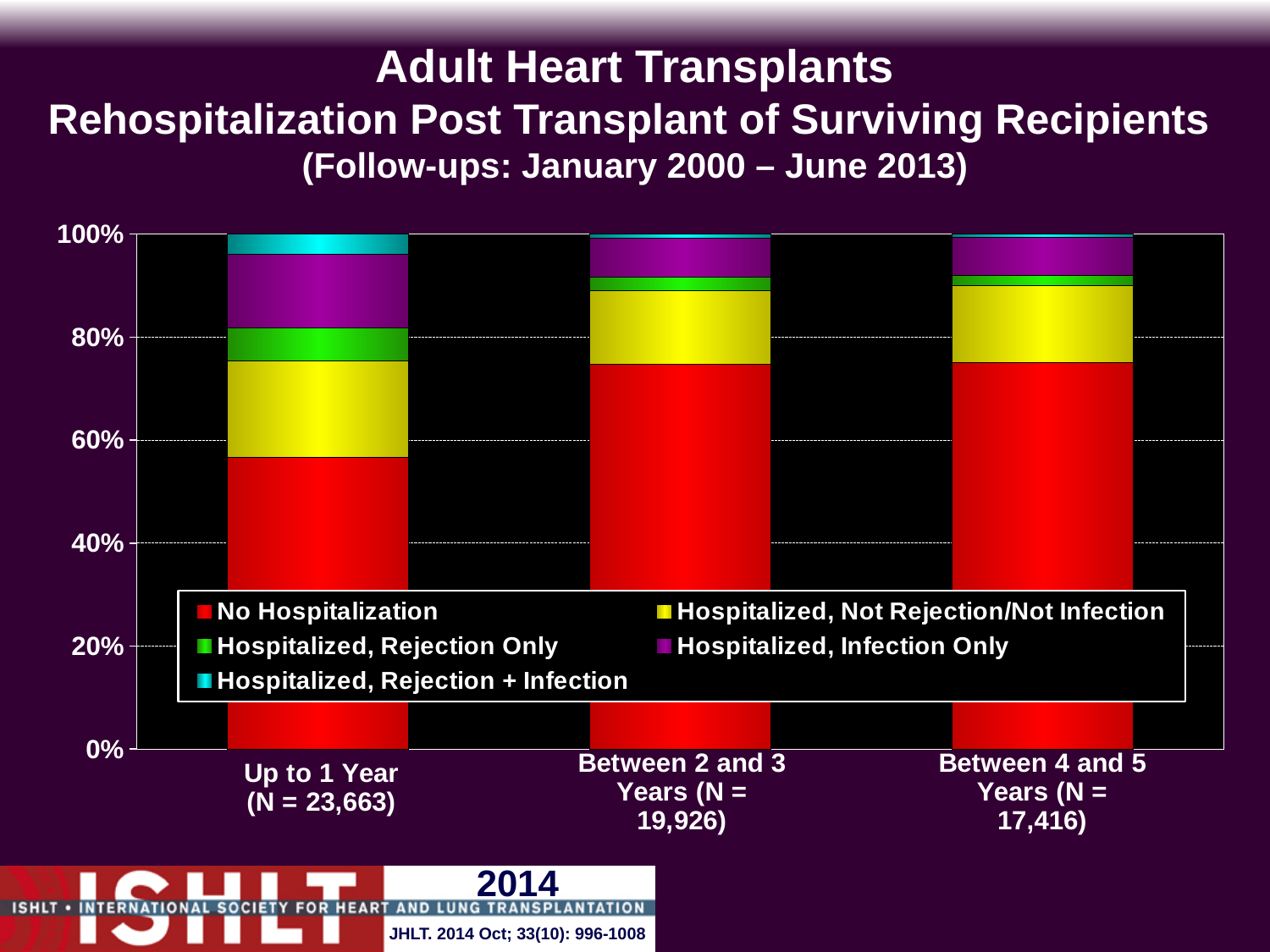
Is the No Hospitalization share for Between 2 and 3 Years greater or less than 60%? greater Is the No Hospitalization share for Between 4 and 5 Years greater or less than 80%? less How many series does the legend list? 5 Which legend entry is shown in red? No Hospitalization Does the No Hospitalization share rise or fall from Up to 1 Year to Between 2 and 3 Years? rise What is the N for the Up to 1 Year category? 23,663 What kind of chart is shown on the slide? Stacked bar chart Which is larger, the No Hospitalization share for Up to 1 Year or for Between 4 and 5 Years? Between 4 and 5 Years What is the total each stacked bar adds up to? 100% Is the No Hospitalization share for Up to 1 Year greater or less than 60%? less Which follow-up period has the lowest No Hospitalization share? Up to 1 Year How many follow-up period categories are shown on the x axis? 3